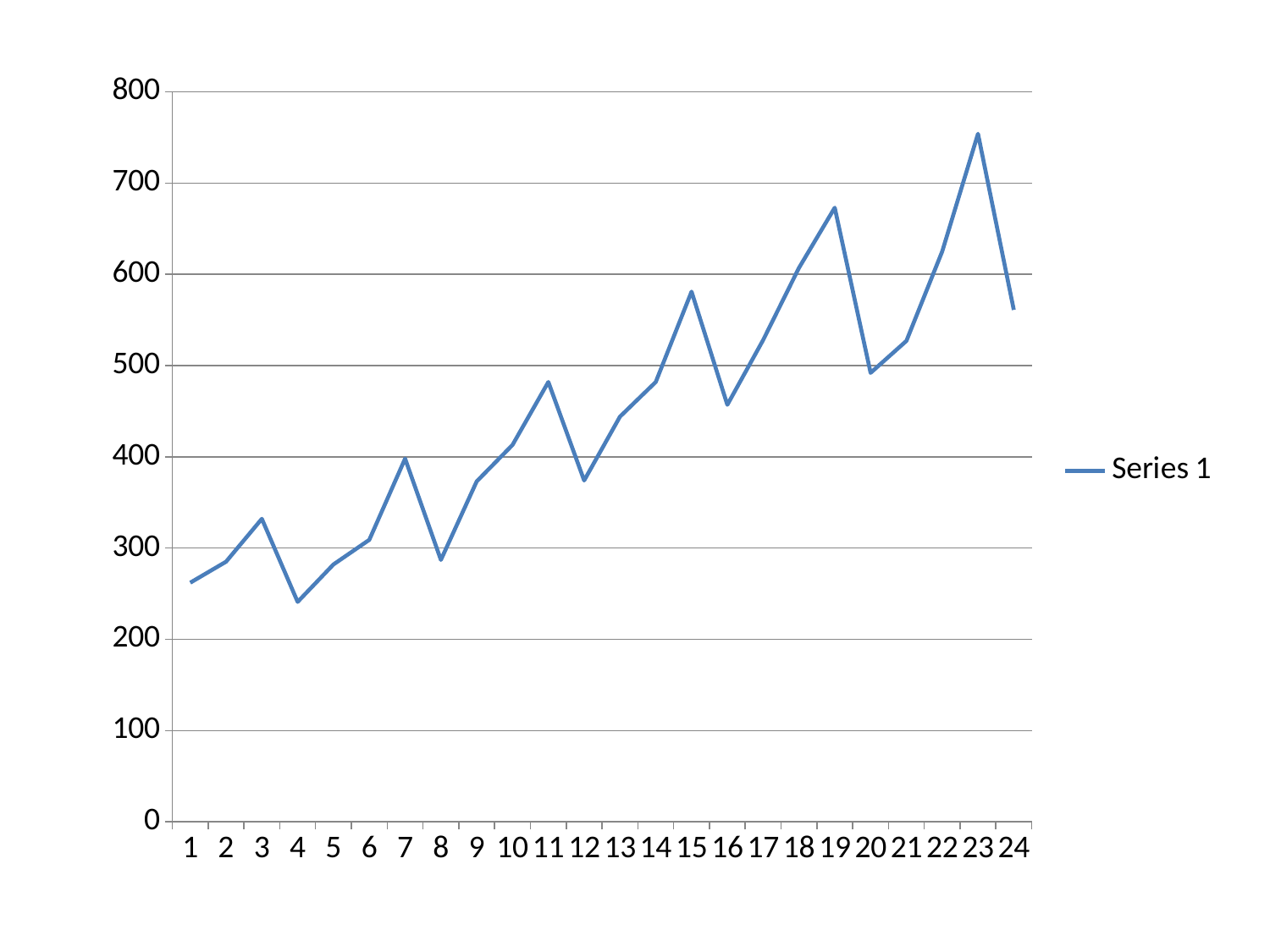
Is the value for point 4 greater or less than 300? less Which has the larger value, point 19 or point 15? 19 At which x-axis point does Series 1 reach its highest value? 23 Overall, do the values of Series 1 rise or fall from point 1 to point 24? rise Is the value for point 15 greater or less than 500? greater How many points are plotted along the x axis? 24 What is the name of the series shown in the legend? Series 1 At which x-axis point does Series 1 reach its lowest value? 4 Is the value for point 19 greater or less than 600? greater How many series does the legend list? 1 What kind of chart is shown on the slide? line chart